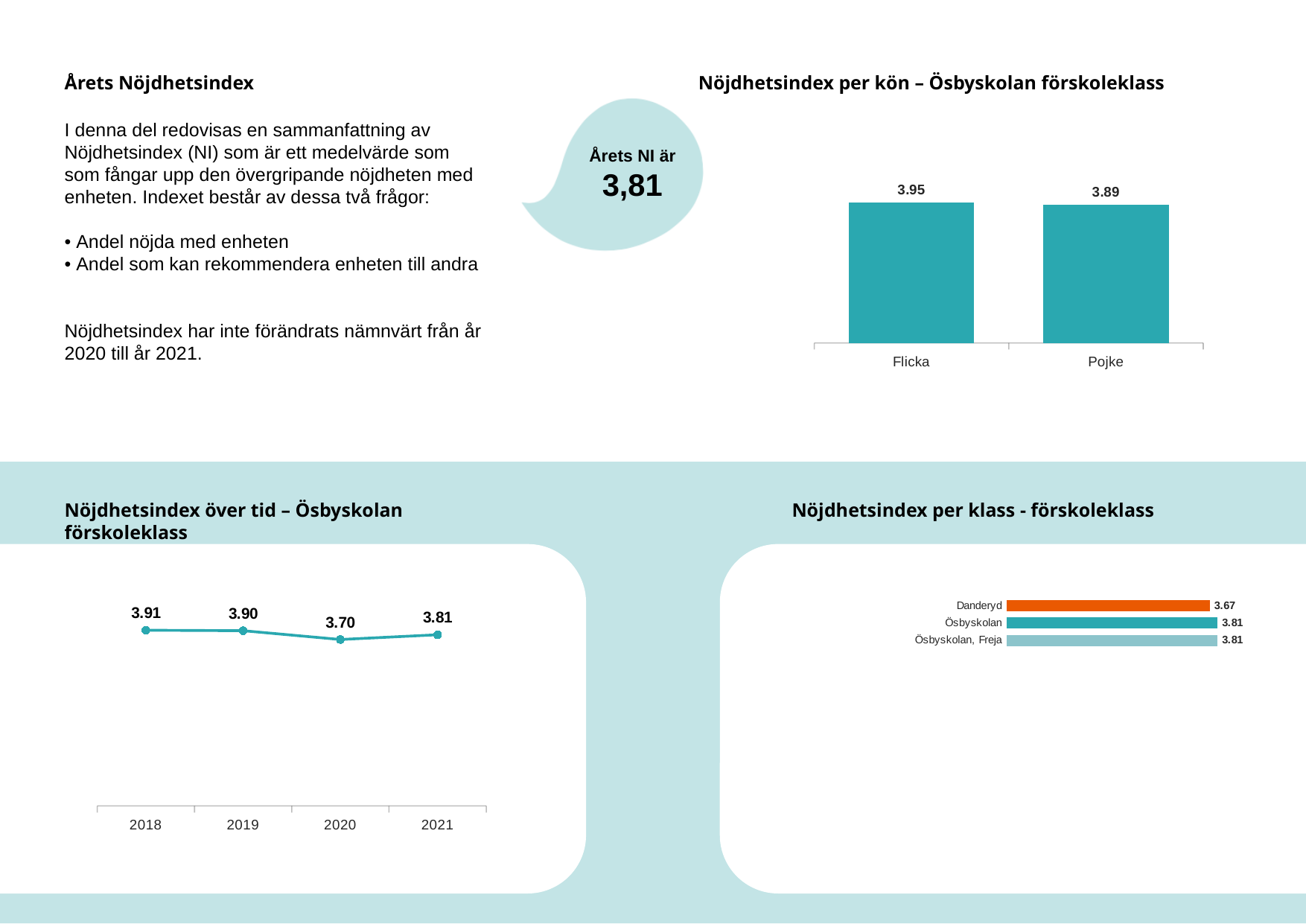
In the chart 'Nöjdhetsindex per klass - förskoleklass', what is the value for Danderyd? 3.67 In the chart 'Nöjdhetsindex över tid – Ösbyskolan förskoleklass', what is the difference between the values for 2021 and 2020? 0.11 What kind of chart is 'Nöjdhetsindex över tid – Ösbyskolan förskoleklass'? Line chart In the chart 'Nöjdhetsindex per klass - förskoleklass', which category has the lowest value? Danderyd In the chart 'Nöjdhetsindex per kön – Ösbyskolan förskoleklass', what is the difference between the values for Flicka and Pojke? 0.06 In the chart 'Nöjdhetsindex över tid – Ösbyskolan förskoleklass', which year has the lowest value? 2020 In the chart 'Nöjdhetsindex per kön – Ösbyskolan förskoleklass', which category has the higher value, Flicka or Pojke? Flicka In the chart 'Nöjdhetsindex över tid – Ösbyskolan förskoleklass', what is the value for 2020? 3.70 In the chart 'Nöjdhetsindex per kön – Ösbyskolan förskoleklass', what is the value for Pojke? 3.89 In the chart 'Nöjdhetsindex per kön – Ösbyskolan förskoleklass', what is the value for Flicka? 3.95 In the chart 'Nöjdhetsindex över tid – Ösbyskolan förskoleklass', which year has the highest value? 2018 In the chart 'Nöjdhetsindex över tid – Ösbyskolan förskoleklass', how many years are plotted? 4